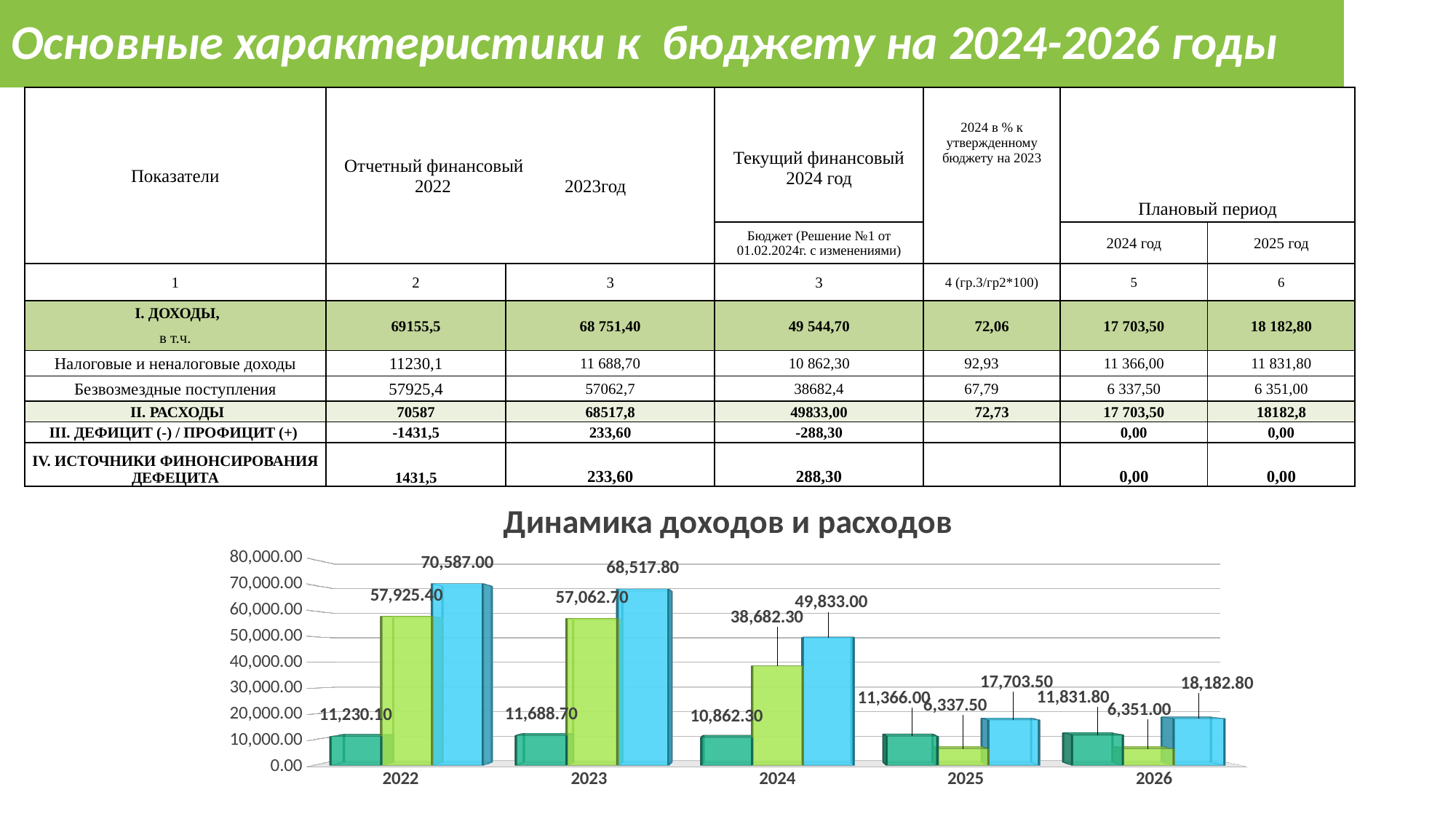
In the chart "Динамика доходов и расходов", what is the value of the light green bar for 2024? 38,682.30 In the chart "Динамика доходов и расходов", which year has the lowest blue bar? 2025 What is the title of the chart on the slide? Динамика доходов и расходов In the chart "Динамика доходов и расходов", which is larger: the blue bar for 2025 or the blue bar for 2026? 2026 In the chart "Динамика доходов и расходов", do the blue bars rise or fall from 2022 to 2025? fall In the chart "Динамика доходов и расходов", what is the value of the dark green bar for 2026? 11,831.80 In the chart "Динамика доходов и расходов", what is the difference between the blue bar and the light green bar for 2022? 12,661.60 What kind of chart is "Динамика доходов и расходов"? bar chart In the chart "Динамика доходов и расходов", what is the value of the light green bar for 2025? 6,337.50 In the chart "Динамика доходов и расходов", what is the value of the blue bar for 2022? 70,587.00 How many years are shown on the x axis of the chart "Динамика доходов и расходов"? 5 In the chart "Динамика доходов и расходов", which year has the highest blue bar? 2022